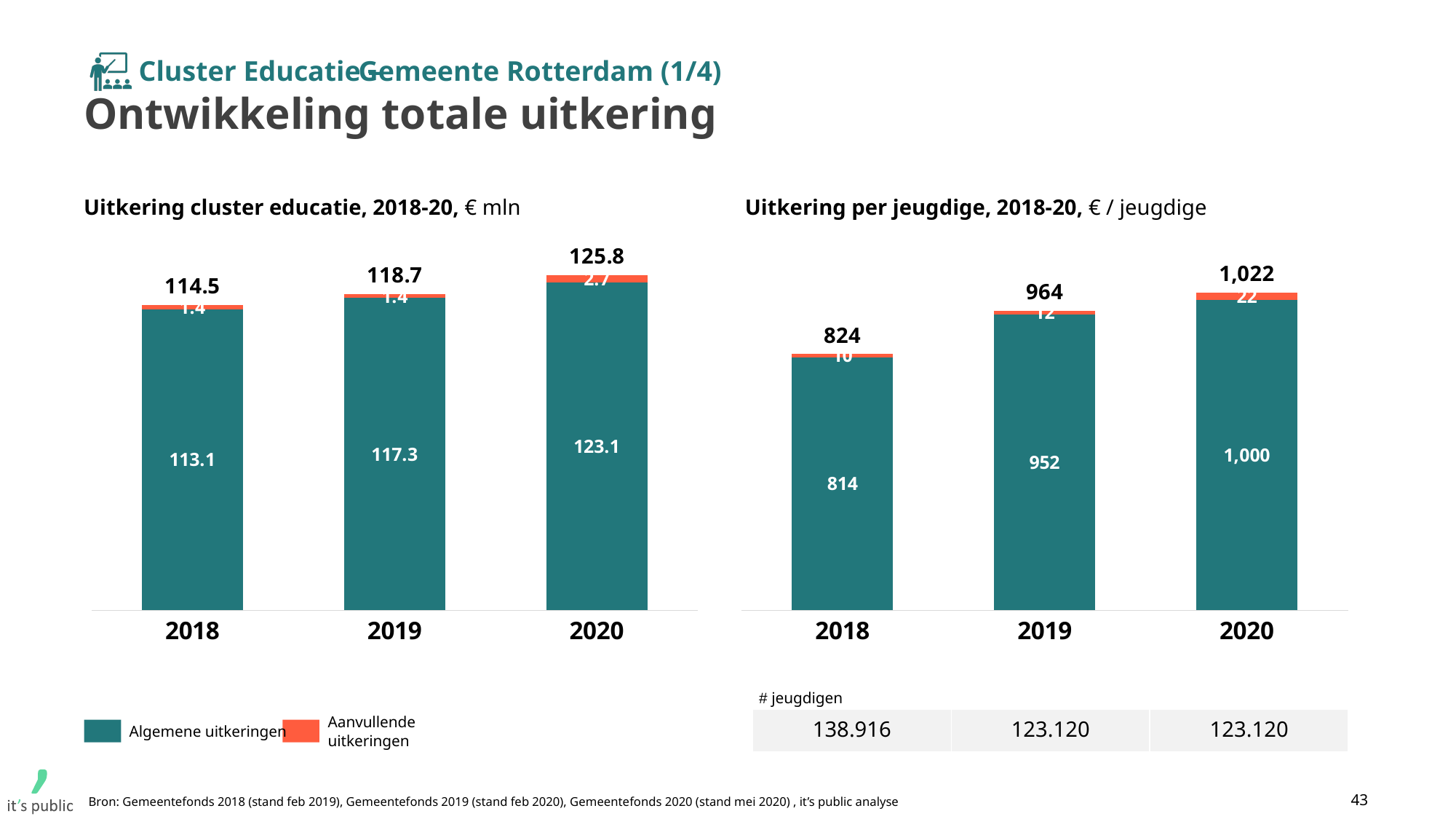
In the chart 'Uitkering cluster educatie, 2018-20', what is the difference between the total for 2020 and the total for 2018? 11.3 In the chart 'Uitkering per jeugdige, 2018-20', do the totals rise or fall from 2018 to 2020? rise In the chart 'Uitkering cluster educatie, 2018-20', what is the value of Aanvullende uitkeringen for 2020? 2.7 In the chart 'Uitkering per jeugdige, 2018-20', what is the value of Algemene uitkeringen for 2018? 814 What kind of chart is 'Uitkering cluster educatie, 2018-20'? stacked bar chart In the chart 'Uitkering per jeugdige, 2018-20', which year has the lowest total uitkering per jeugdige? 2018 In the chart 'Uitkering cluster educatie, 2018-20', what is the value of Algemene uitkeringen for 2019? 117.3 In the chart 'Uitkering per jeugdige, 2018-20', what is the total of the stacked bar for 2019? 964 In the chart 'Uitkering cluster educatie, 2018-20', what is the total of the stacked bar for 2020? 125.8 How many series does the legend on the slide list? 2 In the chart 'Uitkering cluster educatie, 2018-20', which year has the highest total uitkering? 2020 In the chart 'Uitkering per jeugdige, 2018-20', what is the value of Aanvullende uitkeringen for 2020? 22